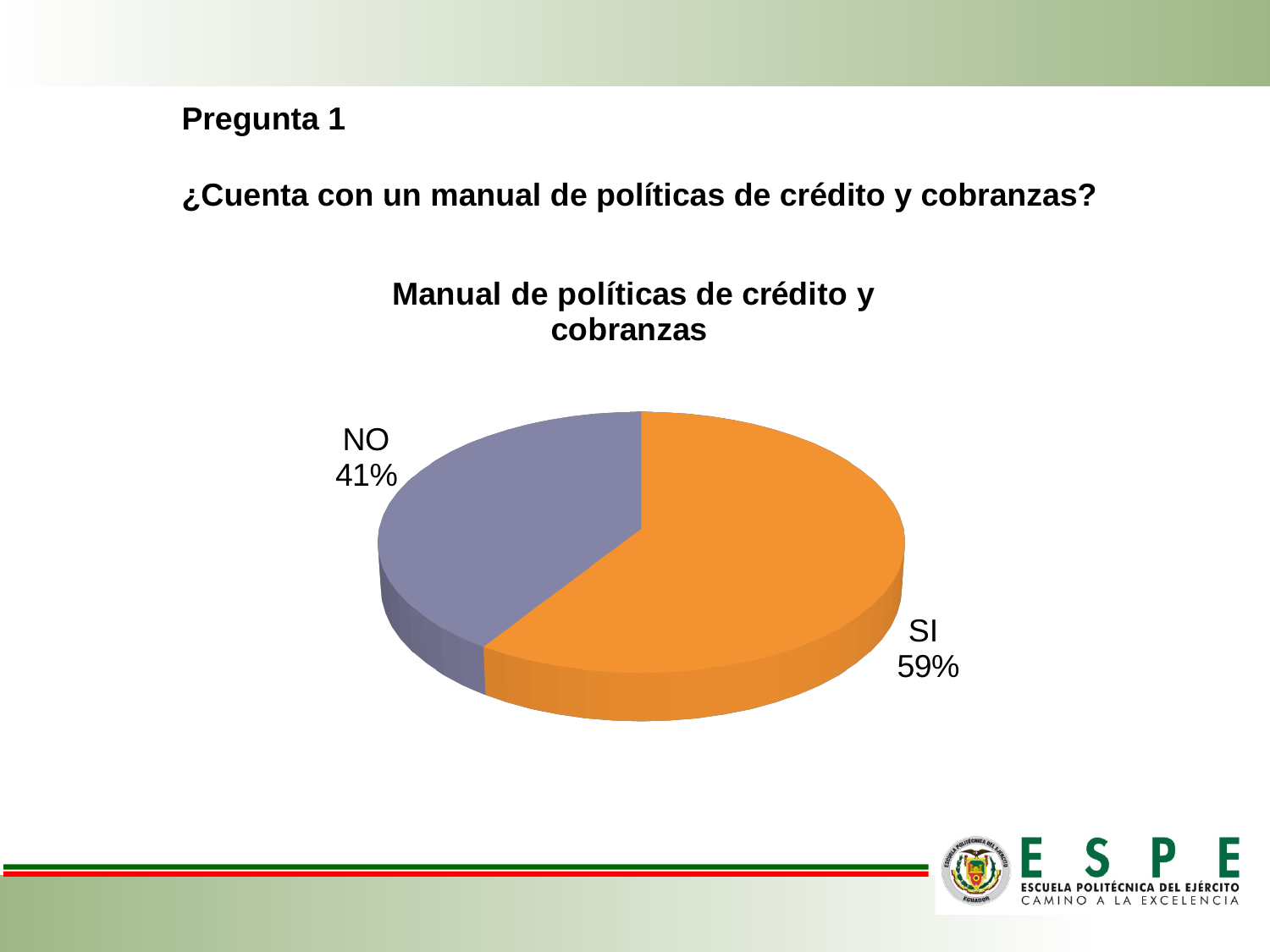
What percentage of the pie corresponds to NO? 41% Which slice is the largest in the pie chart? SI How many slices does the pie chart have? 2 What is the difference in percentage points between the SI and NO slices? 18 What percentage of the pie corresponds to SI? 59% Which slice is the smallest in the pie chart? NO What is the title of the chart? Manual de políticas de crédito y cobranzas Which is larger, the SI slice or the NO slice? SI What type of chart is shown on the slide? pie chart What colour is the SI slice? orange What share of the pie does the SI slice represent? 59%